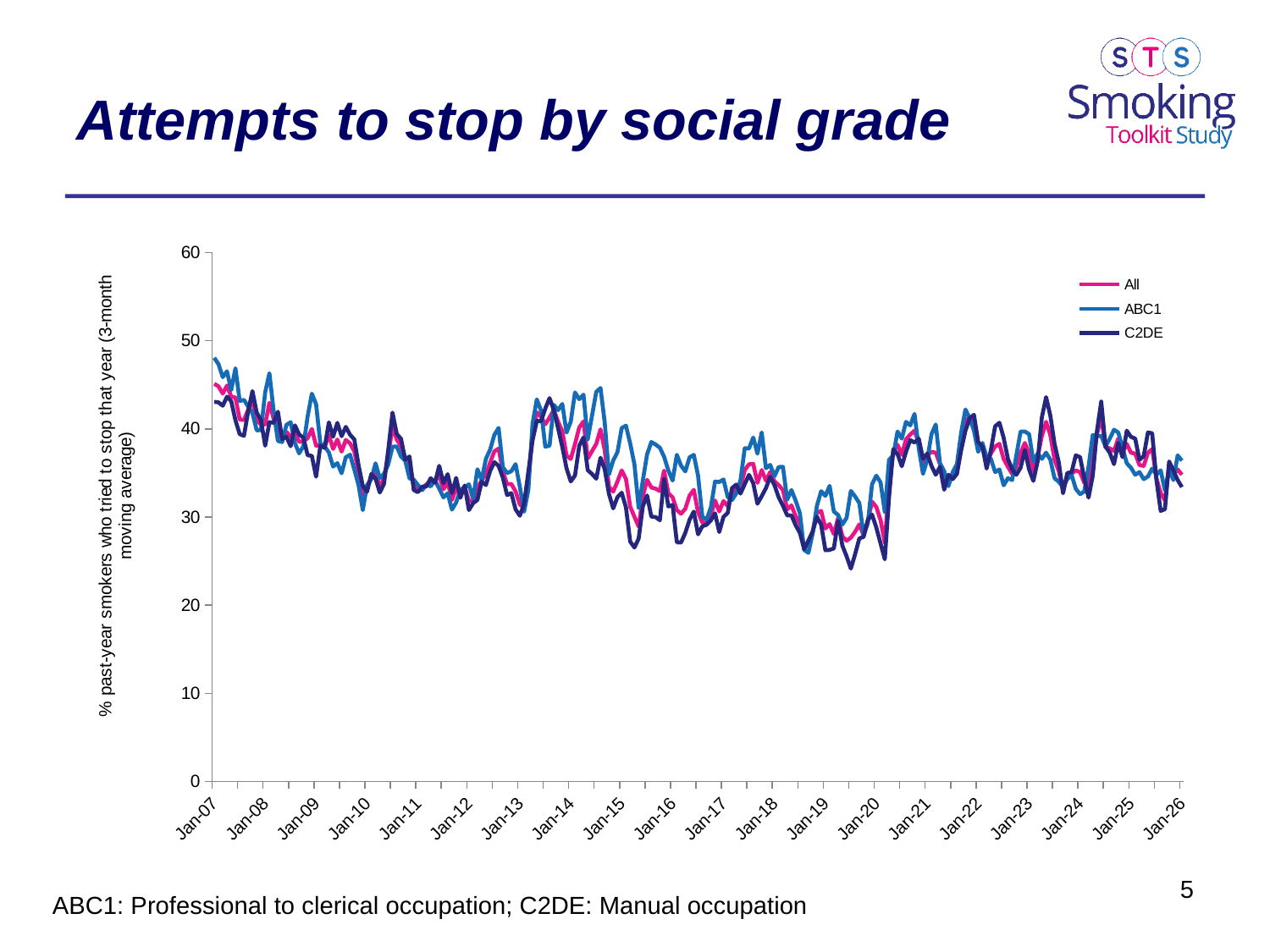
Is the lowest value for C2DE around Jan-20 greater or less than 30? less At Jan-07, is the value for ABC1 or C2DE larger? ABC1 Is the value for All at Jan-26 greater or less than 40? less Is the value for All at Jan-07 greater or less than 40? greater What kind of chart is shown on the slide? Line chart How many year labels are shown on the x axis, from Jan-07 to Jan-26? 20 Which series has the highest value at Jan-07? ABC1 How many series does the legend list? 3 What is the title of the slide's chart? Attempts to stop by social grade Overall, do the values rise or fall between Jan-07 and Jan-20? fall What are the three series named in the legend? All, ABC1, C2DE